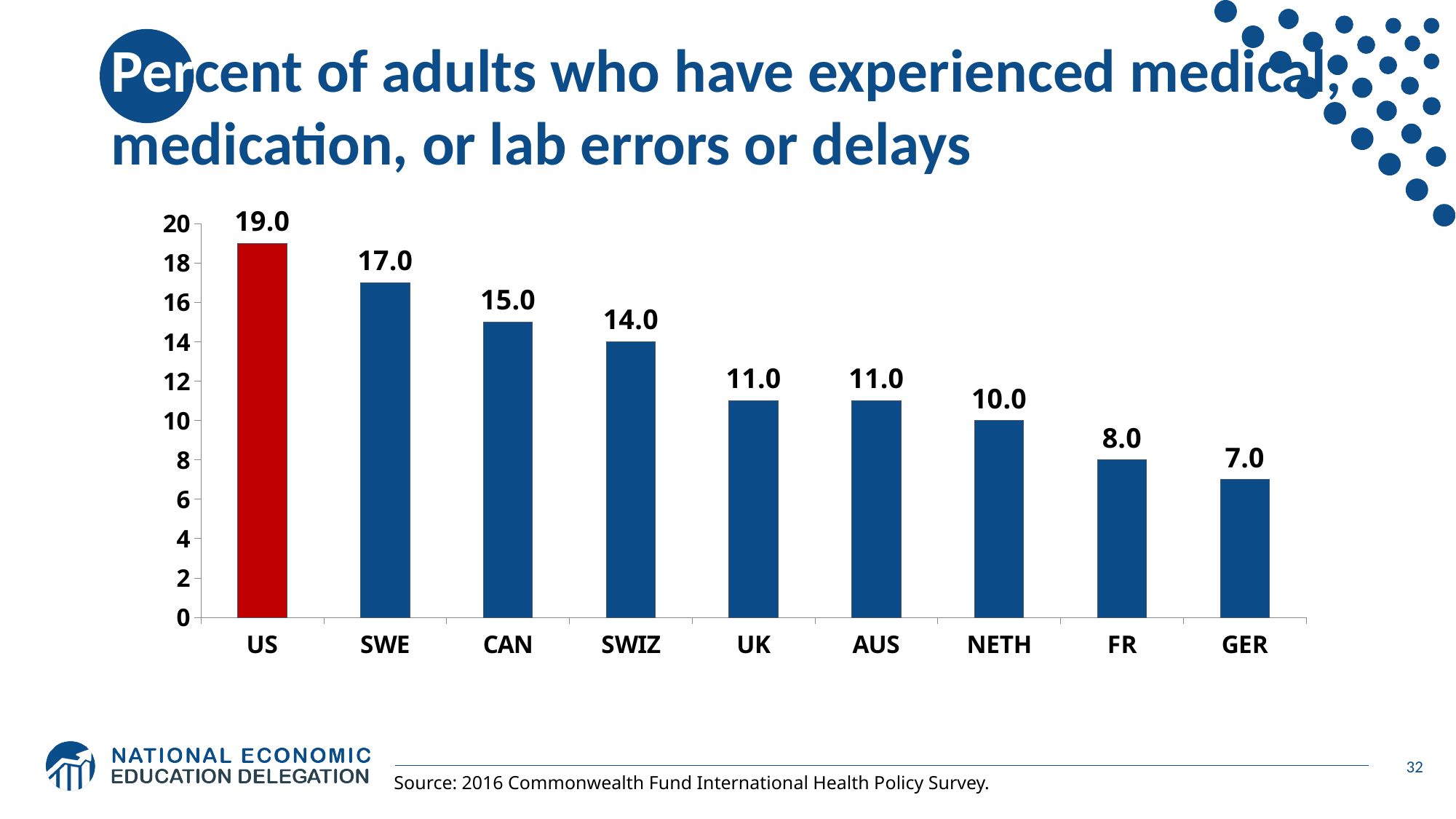
What kind of chart is shown on the slide? bar chart Which country has the lowest value? GER What is the value for the US? 19.0 How many countries are shown in the chart? 9 What is the difference between the values for SWE and CAN? 2.0 Which is larger, the value for FR or the value for NETH? NETH What is the value for SWIZ? 14.0 Which country has the highest value? US What is the difference between the values for the US and GER? 12.0 Is the value for CAN greater or less than 10? greater Which bar is coloured red rather than blue? US What is the value for NETH? 10.0